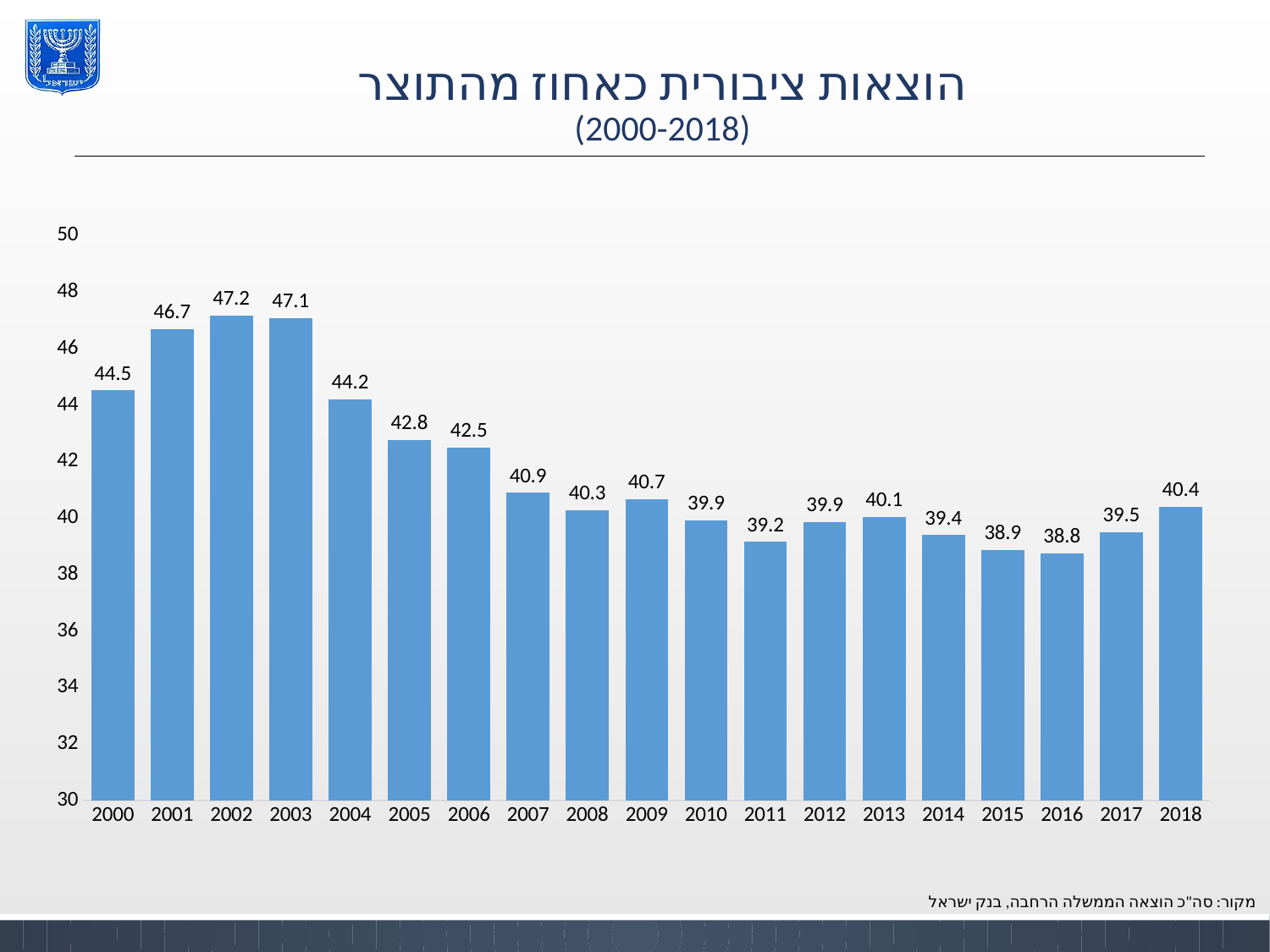
What is the difference between the values for 2002 and 2016? 8.4 What is the value for 2002? 47.2 What is the value for 2018? 40.4 Do the values generally rise or fall from 2003 to 2011? fall How many years are shown on the x axis? 19 Which year has the highest value? 2002 What kind of chart is shown on the slide? bar chart Which year has the lowest value? 2016 What is the difference between the values for 2000 and 2004? 0.3 Is the value for 2003 greater or less than 46? greater What is the value for 2016? 38.8 Which is larger, the value for 2005 or the value for 2009? 2005